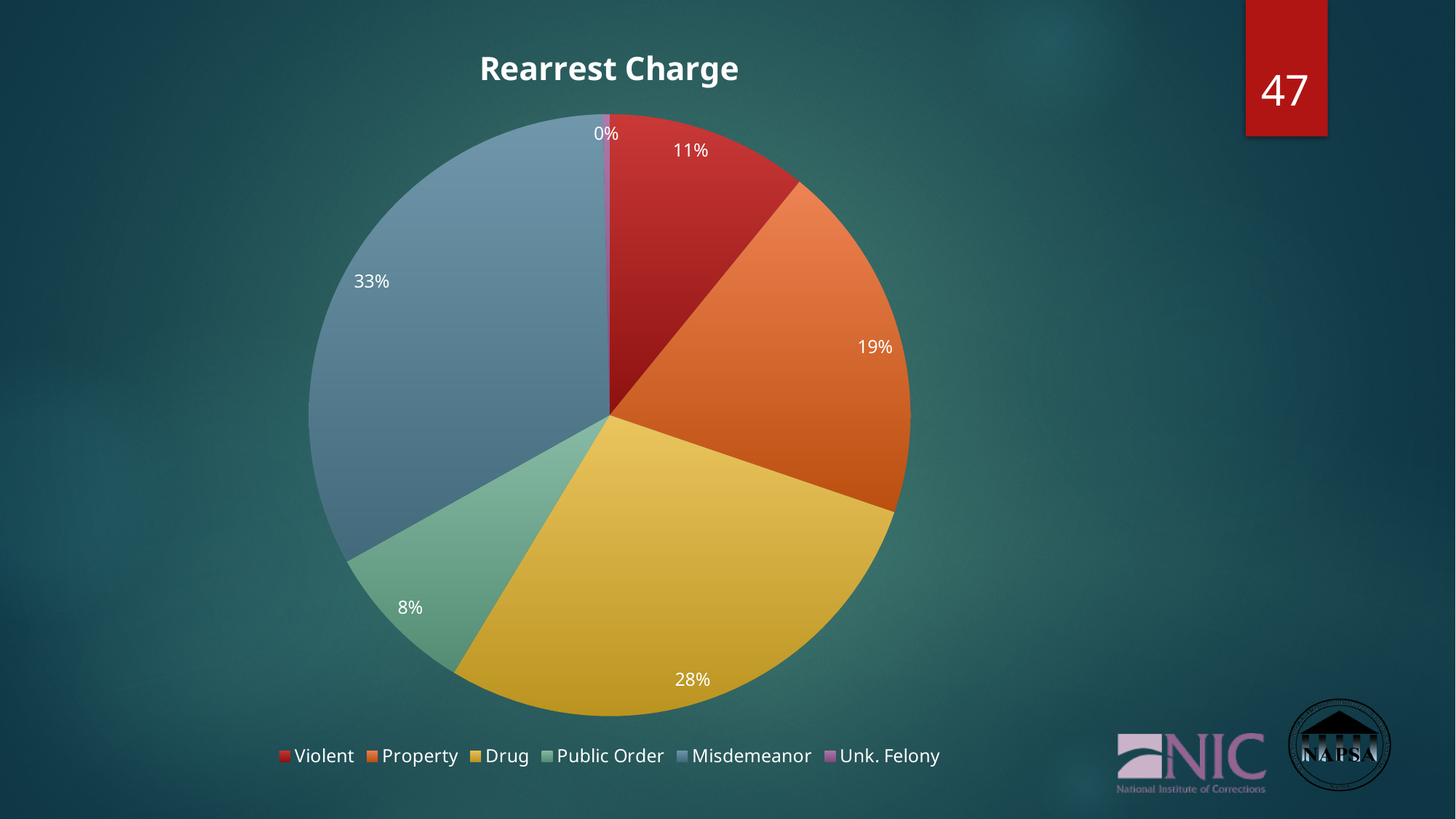
What percentage of rearrest charges are Property? 19% Which is larger, the Violent slice or the Public Order slice? Violent What percentage of rearrest charges are Drug? 28% What is the difference in percentage points between the Drug and Property slices? 9 Which rearrest charge category has the largest share? Misdemeanor How many categories does the legend list? 6 What is the title of the chart? Rearrest Charge What percentage of rearrest charges are Public Order? 8% Which rearrest charge category has the smallest share? Unk. Felony What percentage of rearrest charges are Violent? 11% What percentage of rearrest charges are Misdemeanor? 33% What type of chart is shown on the slide? pie chart